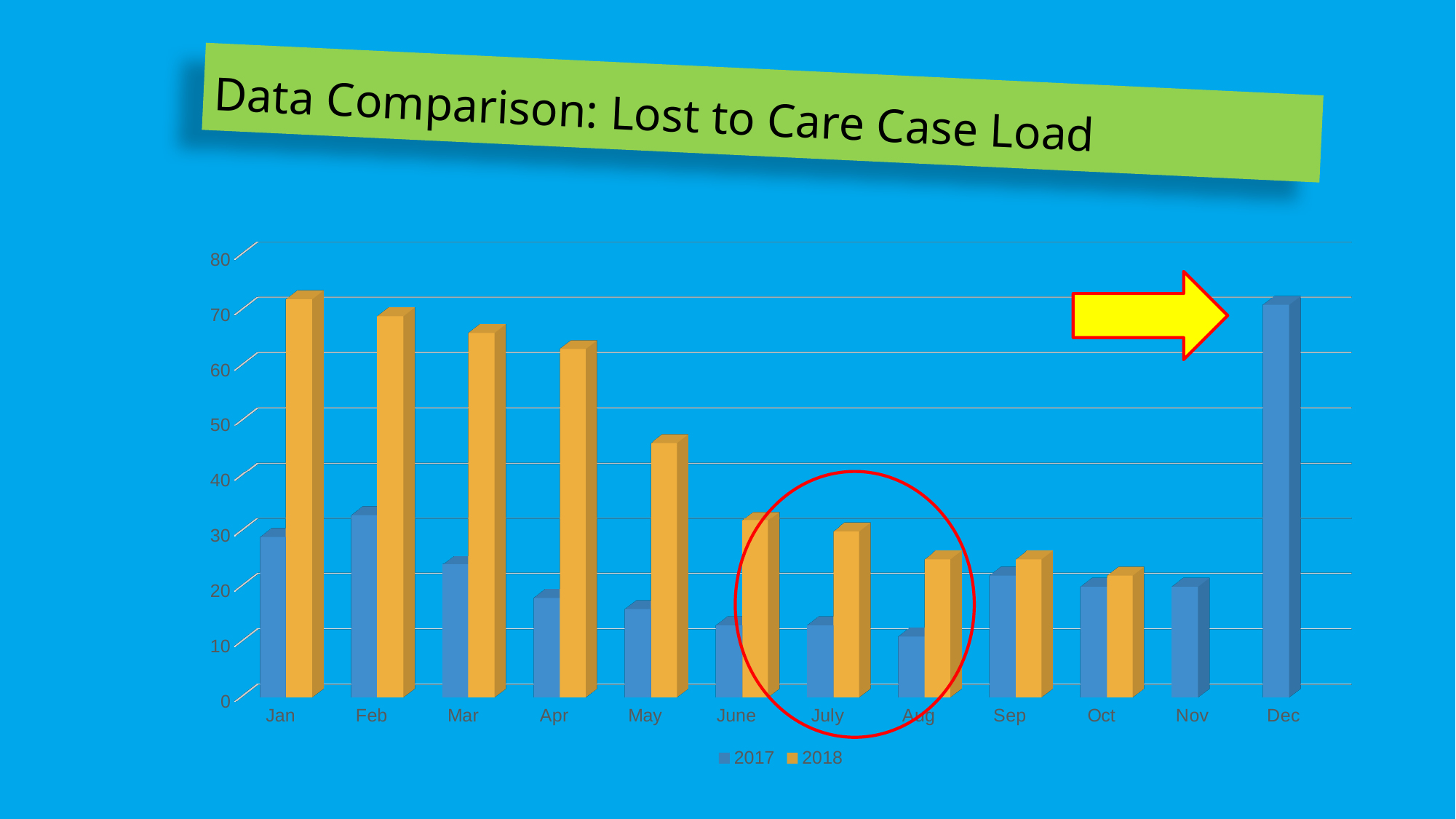
Which is larger in Feb, the 2017 value or the 2018 value? 2018 Is the 2018 value for Jan greater or less than 70? greater How many series does the legend list? 2 Is the 2017 value for Dec greater or less than 60? greater Which month has the lowest value for the 2017 series? Aug Which month has the highest value for the 2018 series? Jan How many months are shown along the x axis? 12 What is the title of the chart on the slide? Data Comparison: Lost to Care Case Load Is the 2018 value for May greater or less than 50? less Which month has the highest value for the 2017 series? Dec What kind of chart is shown on the slide? bar chart Do the 2018 values rise or fall from Jan to Oct? fall